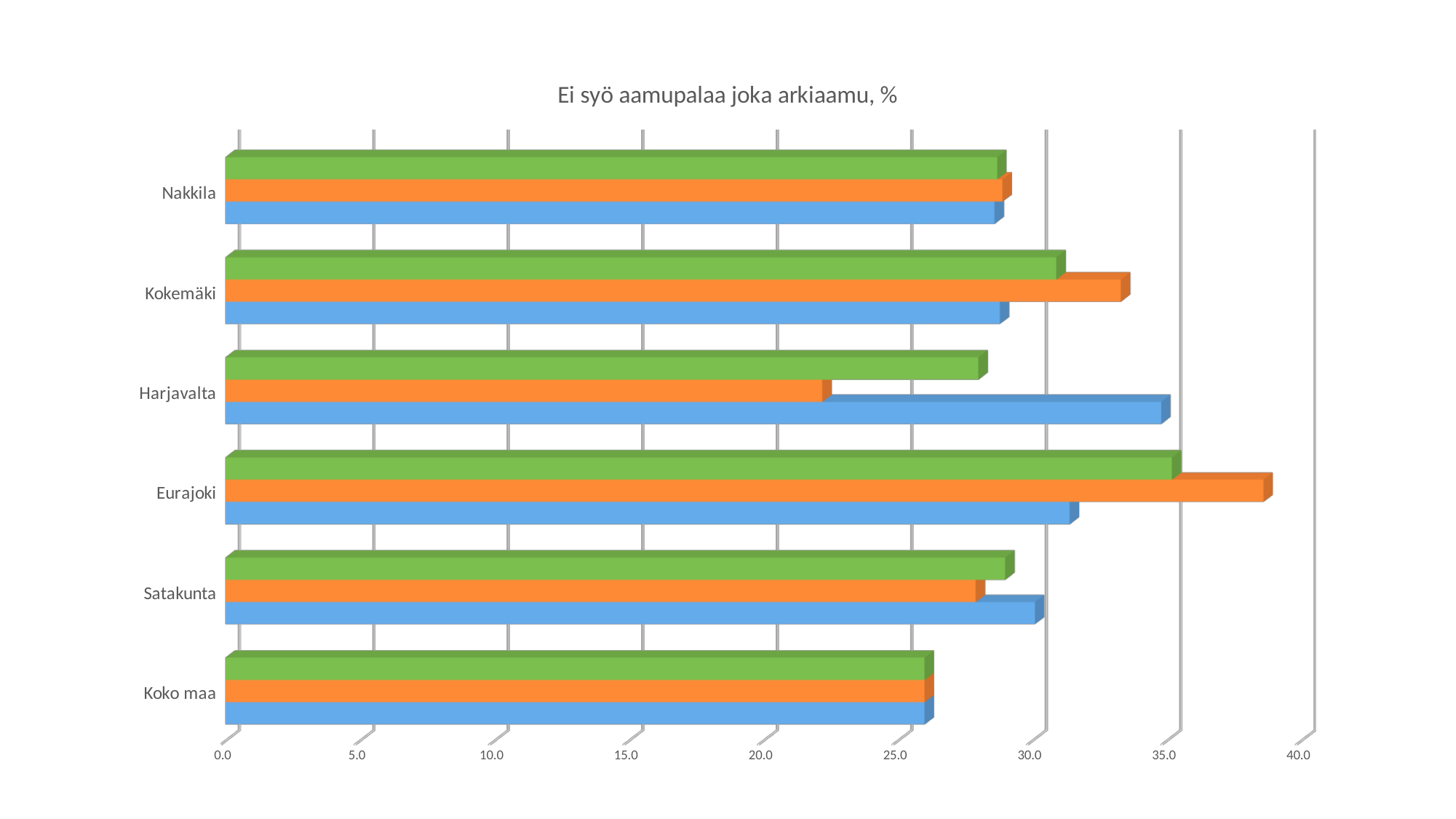
How many categories are shown on the vertical axis of the chart? 6 Is the value of the blue bar for Harjavalta greater or less than 30.0? greater For Harjavalta, which is larger: the blue bar or the orange bar? the blue bar What kind of chart is shown on the slide? bar chart What is the title of the chart? Ei syö aamupalaa joka arkiaamu, % Is the value of the orange bar for Eurajoki greater or less than 35.0? greater Which category has the longest orange bar? Eurajoki Which category has the shortest orange bar? Harjavalta Is the value of the orange bar for Harjavalta greater or less than 25.0? less Which category has the longest blue bar? Harjavalta